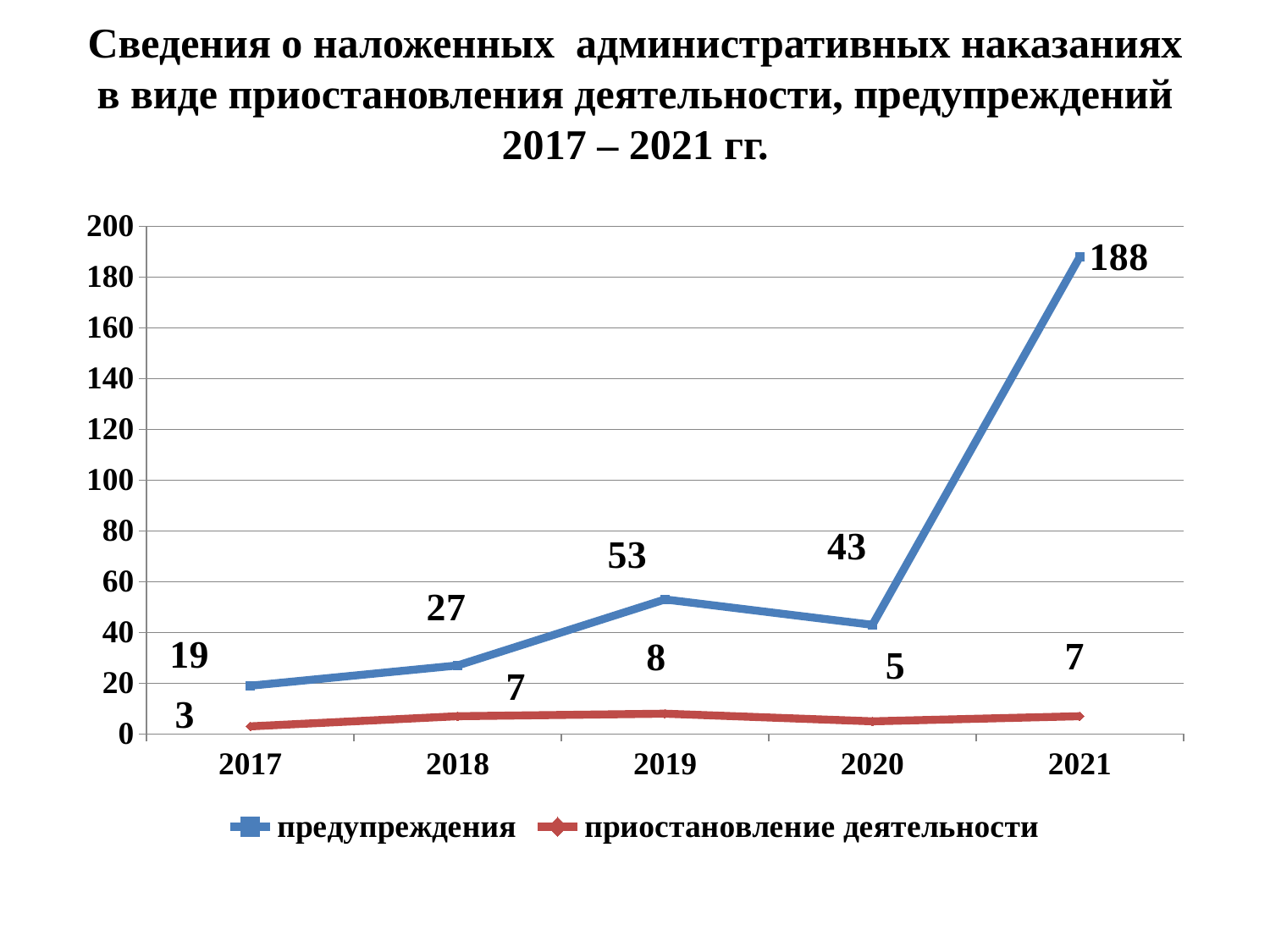
What is the value for предупреждения in 2021? 188 How many years are plotted on the x axis? 5 What is the difference between the предупреждения values for 2021 and 2020? 145 What type of chart is shown on the slide? line chart What is the value for предупреждения in 2019? 53 Which is larger: предупреждения in 2019 or предупреждения in 2020? предупреждения in 2019 In which year is the value for предупреждения highest? 2021 Is the value for предупреждения in 2021 greater or less than 180? greater How many series does the legend list? 2 What is the value for приостановление деятельности in 2017? 3 Which series is drawn in blue? предупреждения In which year is the value for приостановление деятельности lowest? 2017